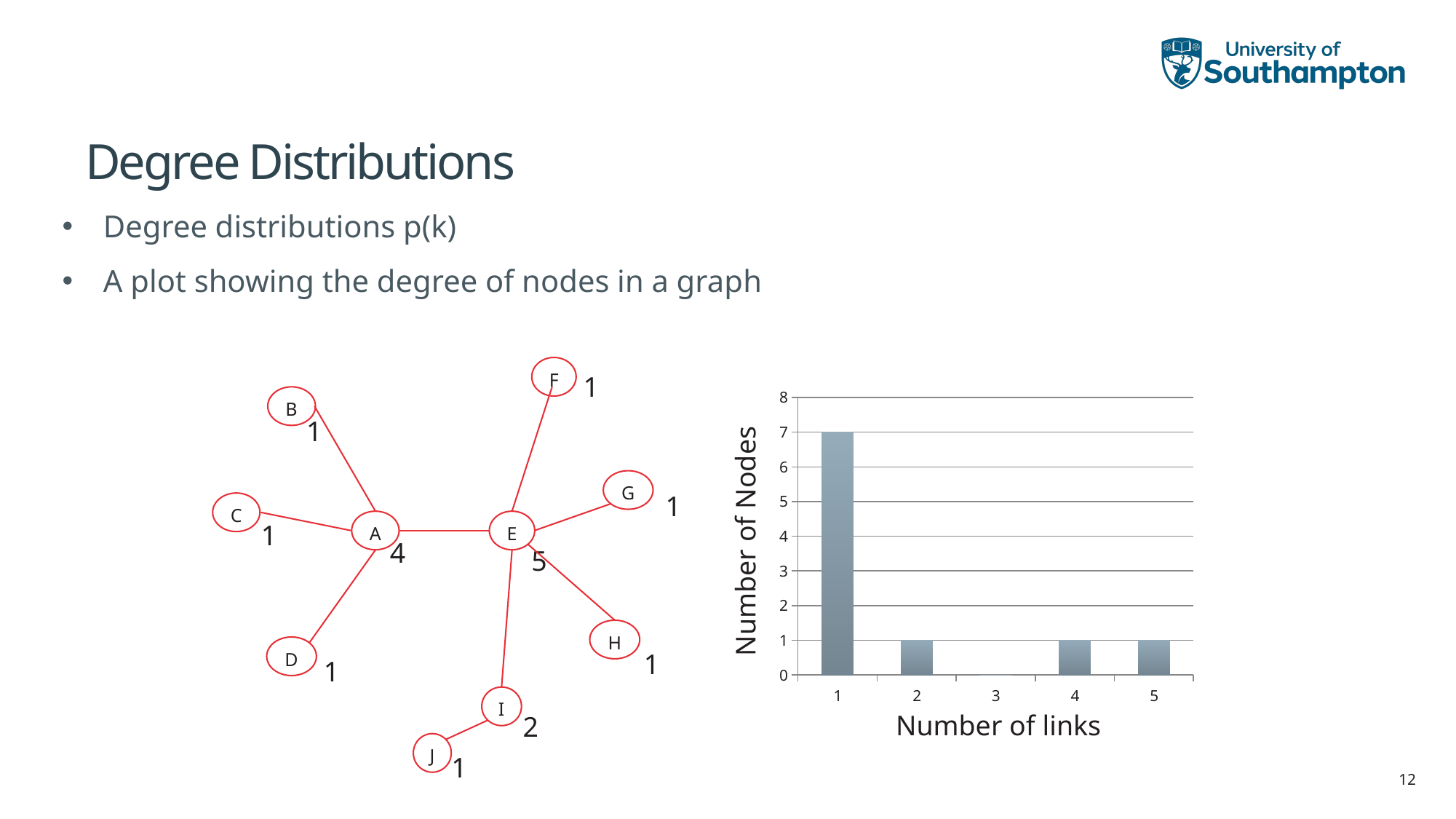
What is the number of nodes with 4 links? 1 Which number of links has no bar (zero nodes)? 3 What is the number of nodes with 2 links? 1 What is the number of nodes with 5 links? 1 What is the label of the y axis of the chart? Number of Nodes What kind of chart is shown on the slide? bar chart What is the difference between the number of nodes with 1 link and the number of nodes with 2 links? 6 Which has more nodes: 1 link or 5 links? 1 link How many categories are shown on the x axis of the chart? 5 What is the number of nodes with 1 link? 7 Is the number of nodes with 1 link greater or less than 5? greater Which number of links has the highest number of nodes? 1